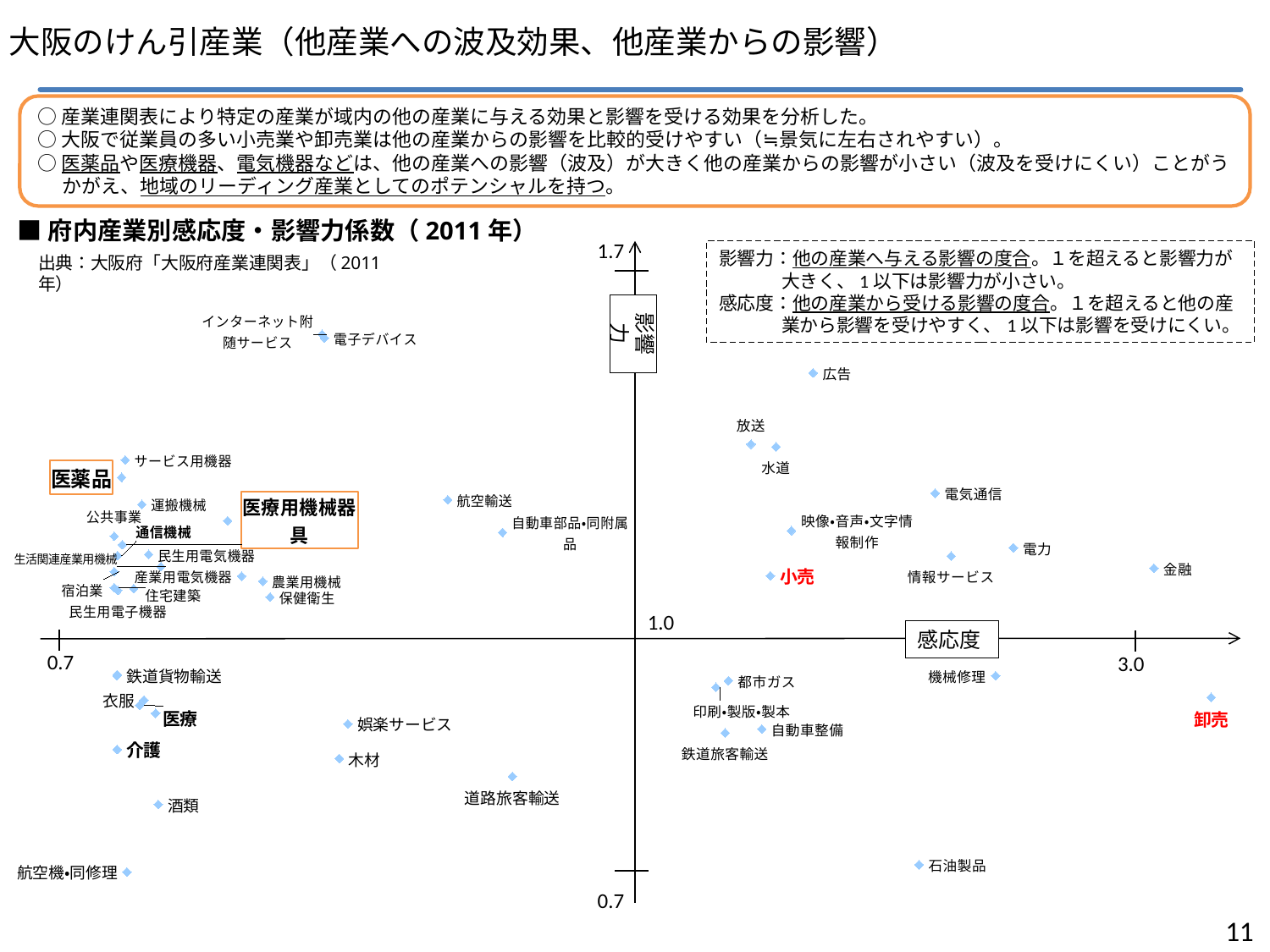
Is the 影響力 value for 介護 greater or less than 1.0? less Is the 影響力 value for 医薬品 greater or less than 1.0? greater Is the 感応度 value for 小売 greater or less than 1.0? greater Which industry has the highest 感応度 value in the chart? 卸売 What is the title of the chart? 府内産業別感応度・影響力係数（2011年） What kind of chart is shown on the slide? scatter chart What is the label of the horizontal axis of the chart? 感応度 Which has the larger 感応度 value, 卸売 or 小売? 卸売